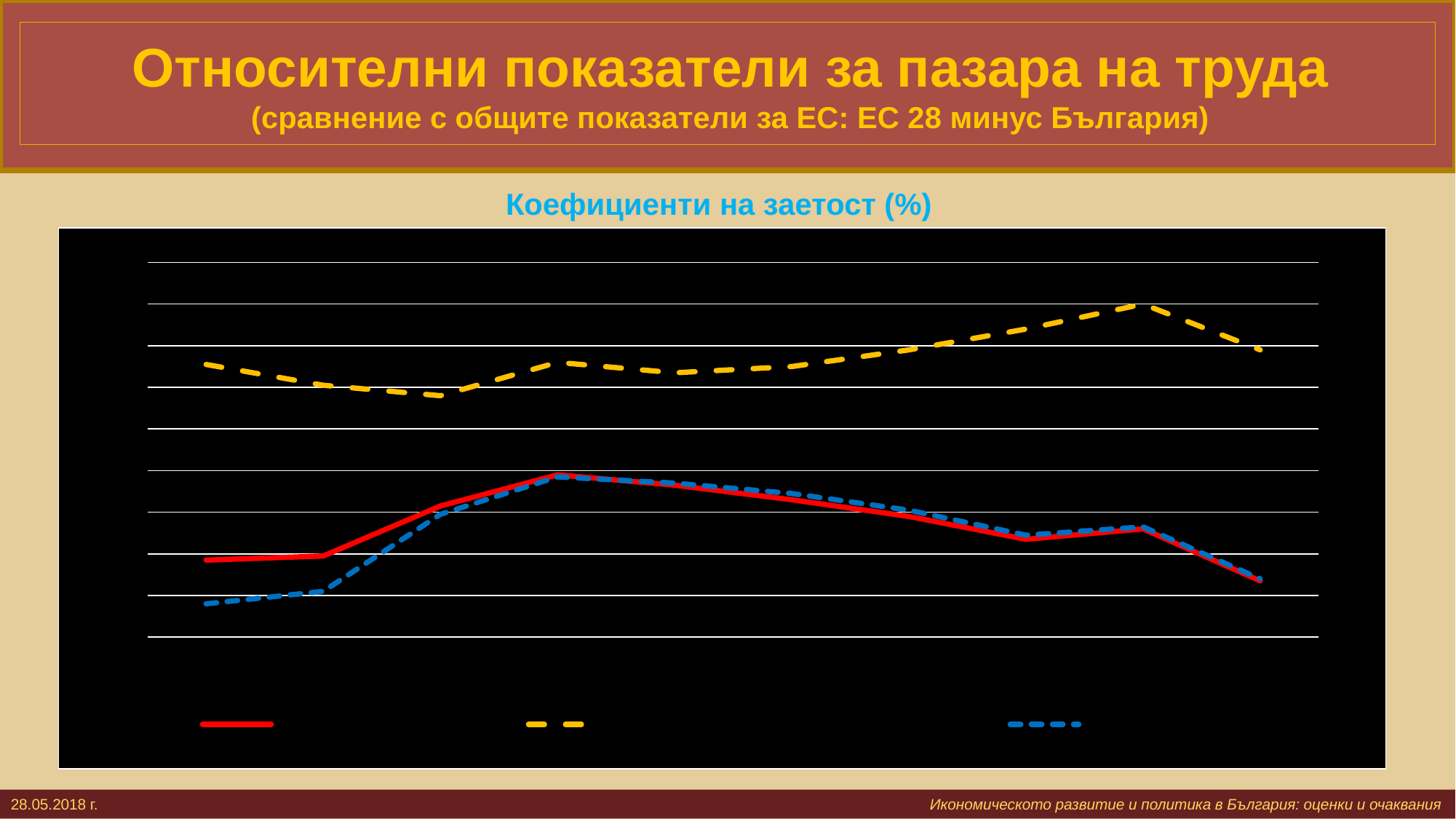
At the leftmost point, which is higher: the red solid line or the blue dashed line? the red solid line How many series does the legend of the chart list? 3 What colours are the three lines in the chart? red, yellow and blue Does the yellow dashed line rise or fall over its last two points? falls Does the red solid line rise or fall from its first point to its fourth point? rises What is the title of the chart? Коефициенти на заетост (%) At the leftmost point, which line is lowest? the blue dashed line Which line is plotted highest across the whole chart? the yellow dashed line What kind of chart is shown on the slide? line chart How many points does each line in the chart have? 10 Does the red solid line rise or fall from its fourth point to its last point? falls